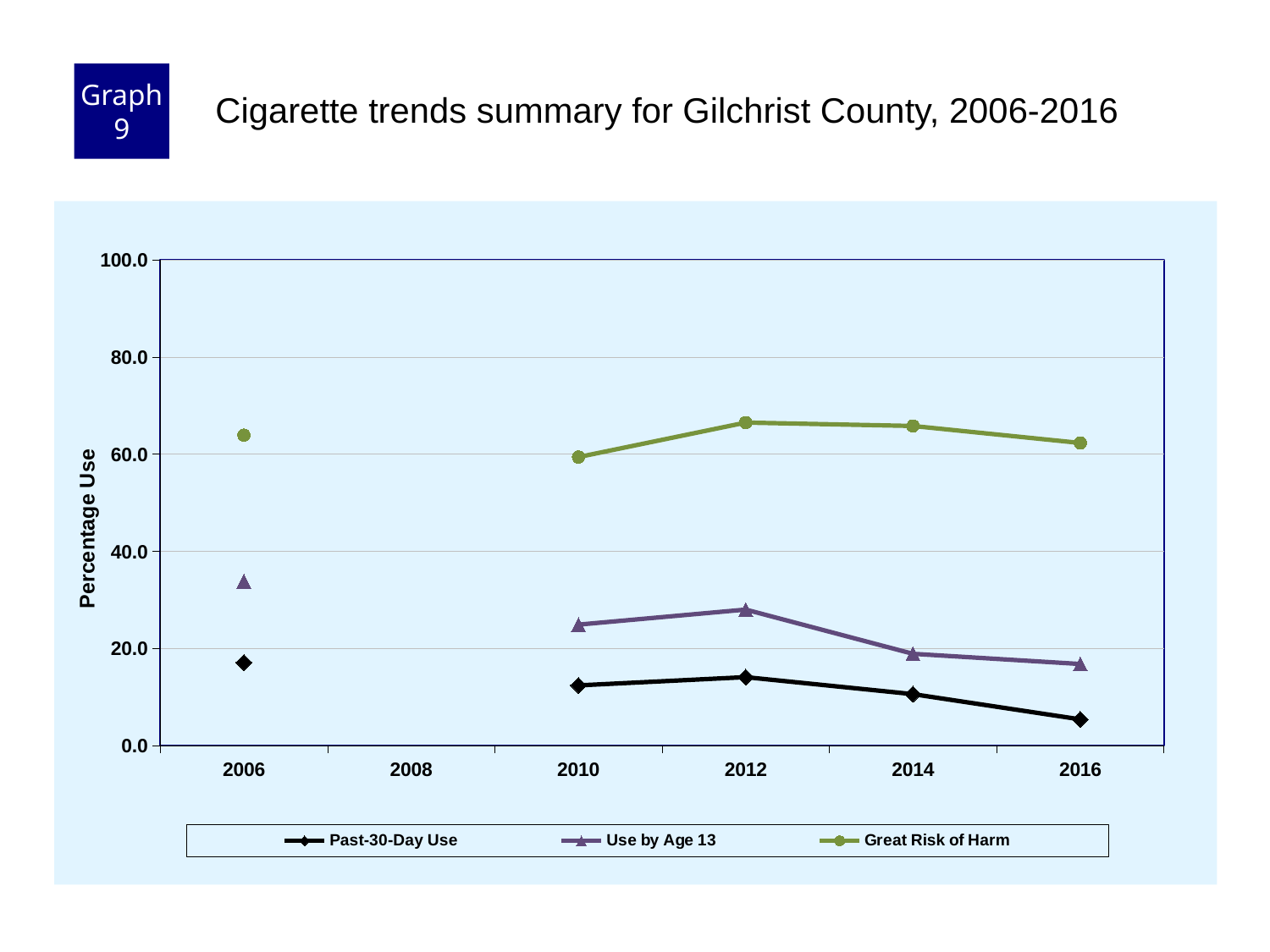
Is the value for Use by Age 13 in 2006 greater or less than 40? less In which year is Past-30-Day Use lowest? 2016 How many years have data points plotted on the chart? 5 How many series does the legend list? 3 Does Past-30-Day Use rise or fall from 2012 to 2016? fall In which year is Past-30-Day Use highest? 2006 Is the value for Past-30-Day Use in 2016 greater or less than 10? less Is the value for Great Risk of Harm in 2012 greater or less than 60? greater Which is larger for Great Risk of Harm: the value in 2010 or the value in 2012? 2012 What kind of chart is shown on the slide? line chart What is the label on the vertical axis? Percentage Use In which year is Use by Age 13 highest? 2006